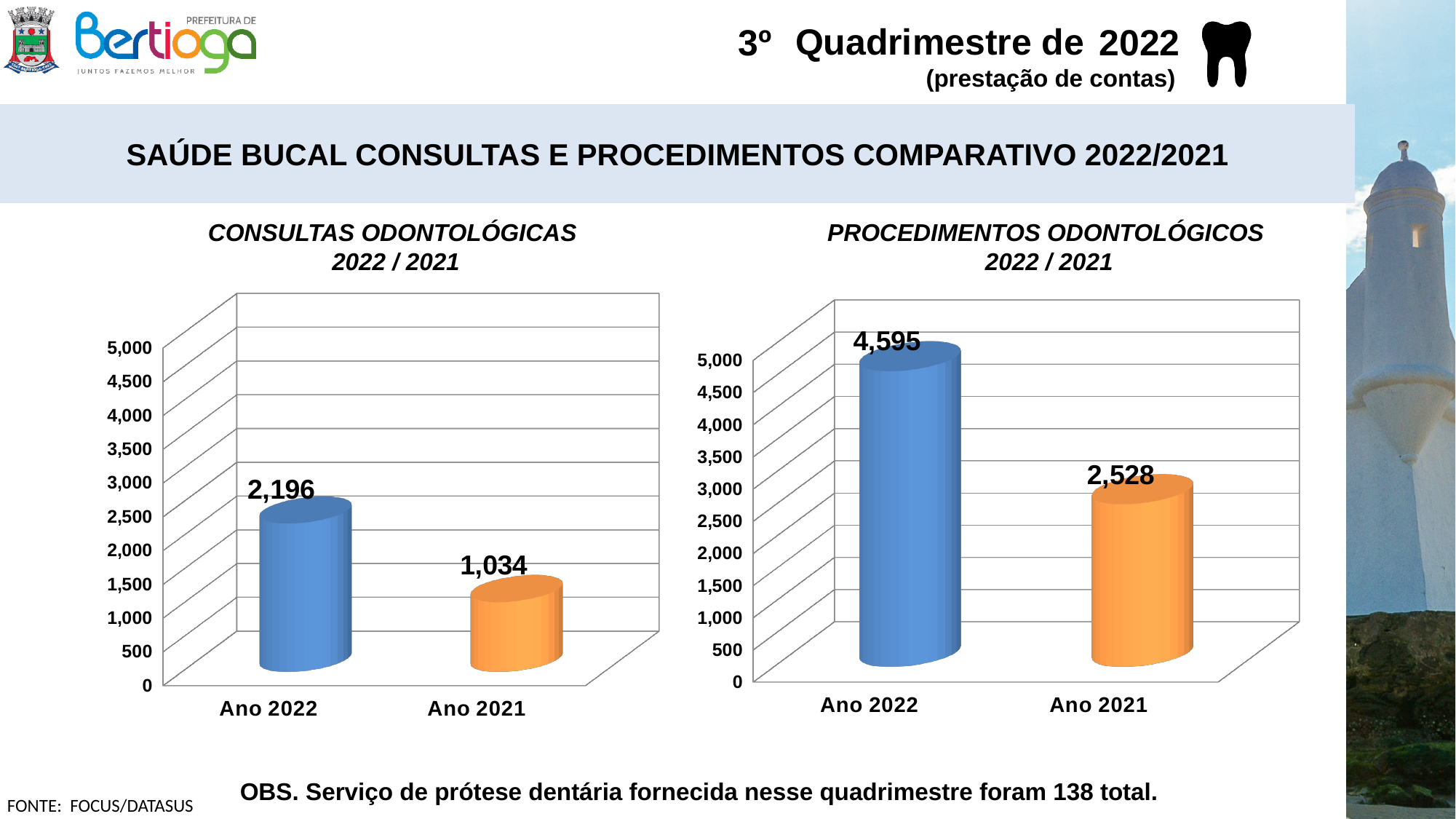
In the PROCEDIMENTOS ODONTOLÓGICOS 2022 / 2021 chart, which year has the lower value? Ano 2021 In the PROCEDIMENTOS ODONTOLÓGICOS 2022 / 2021 chart, what is the value for Ano 2022? 4,595 In the PROCEDIMENTOS ODONTOLÓGICOS 2022 / 2021 chart, what is the value for Ano 2021? 2,528 In the PROCEDIMENTOS ODONTOLÓGICOS 2022 / 2021 chart, is the value for Ano 2021 greater or less than 3,000? less In the CONSULTAS ODONTOLÓGICAS 2022 / 2021 chart, what is the value for Ano 2022? 2,196 In the PROCEDIMENTOS ODONTOLÓGICOS 2022 / 2021 chart, what is the difference between the Ano 2022 and Ano 2021 values? 2,067 In the CONSULTAS ODONTOLÓGICAS 2022 / 2021 chart, what is the difference between the Ano 2022 and Ano 2021 values? 1,162 How many categories are shown in the CONSULTAS ODONTOLÓGICAS 2022 / 2021 chart? 2 In the CONSULTAS ODONTOLÓGICAS 2022 / 2021 chart, what is the value for Ano 2021? 1,034 What kind of chart is the PROCEDIMENTOS ODONTOLÓGICOS 2022 / 2021 chart? Bar chart In the CONSULTAS ODONTOLÓGICAS 2022 / 2021 chart, which year has the higher value? Ano 2022 In the CONSULTAS ODONTOLÓGICAS 2022 / 2021 chart, what colour is the Ano 2021 bar? Orange